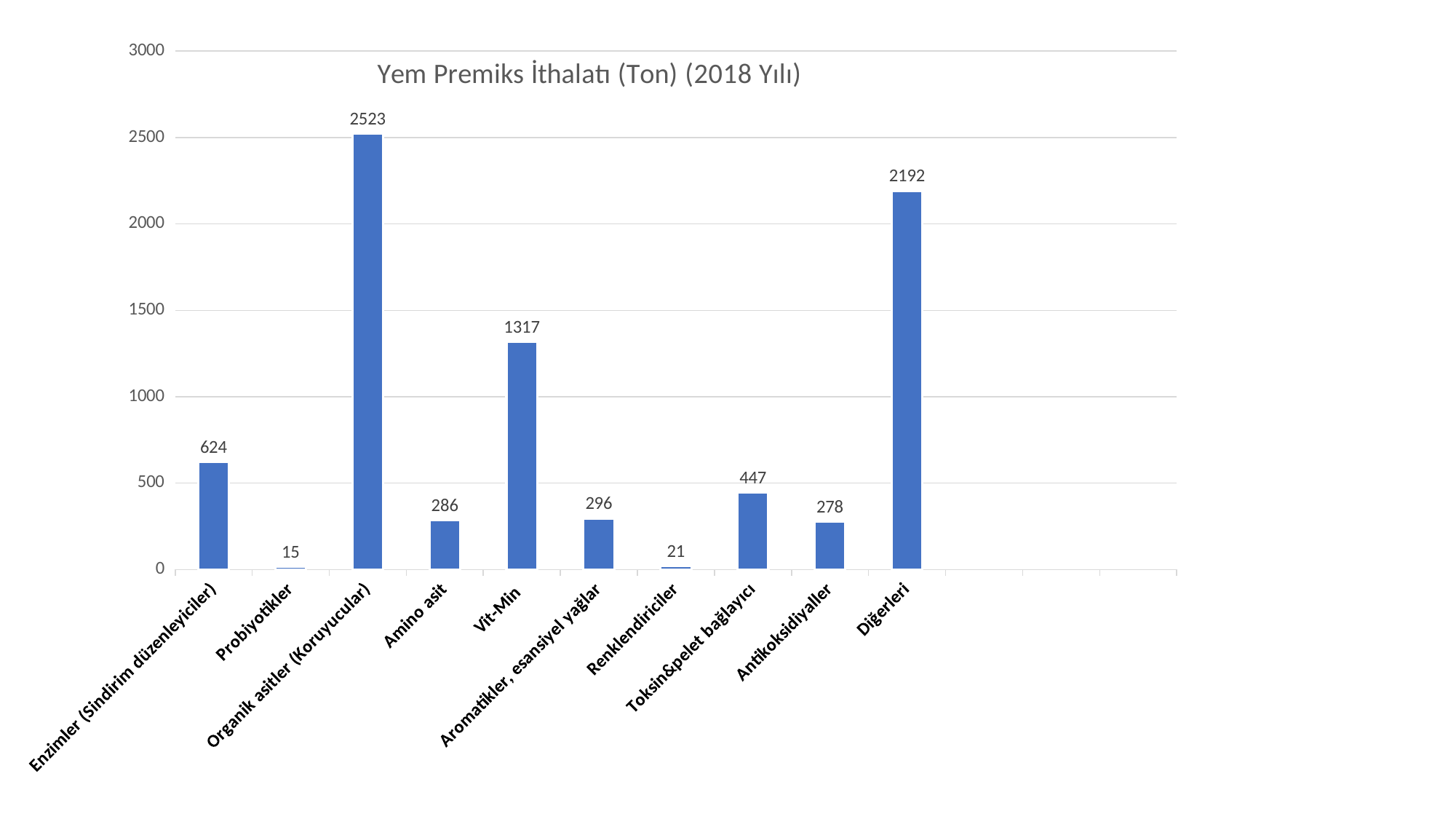
Which category has the lowest value? Probiyotikler What is the difference between the values for Aromatikler, esansiyel yağlar and Amino asit? 10 What is the value for Vit-Min? 1317 What is the title of the chart? Yem Premiks İthalatı (Ton) (2018 Yılı) What kind of chart is this? bar chart What is the value for Enzimler (Sindirim düzenleyiciler)? 624 Which category has the highest value? Organik asitler (Koruyucular) How many categories are shown on the x axis? 10 What is the value for Toksin&pelet bağlayıcı? 447 Is the value for Diğerleri greater or less than 2000? greater Which is larger, the value for Antikoksidiyaller or the value for Toksin&pelet bağlayıcı? Toksin&pelet bağlayıcı What is the difference between the values for Organik asitler (Koruyucular) and Diğerleri? 331